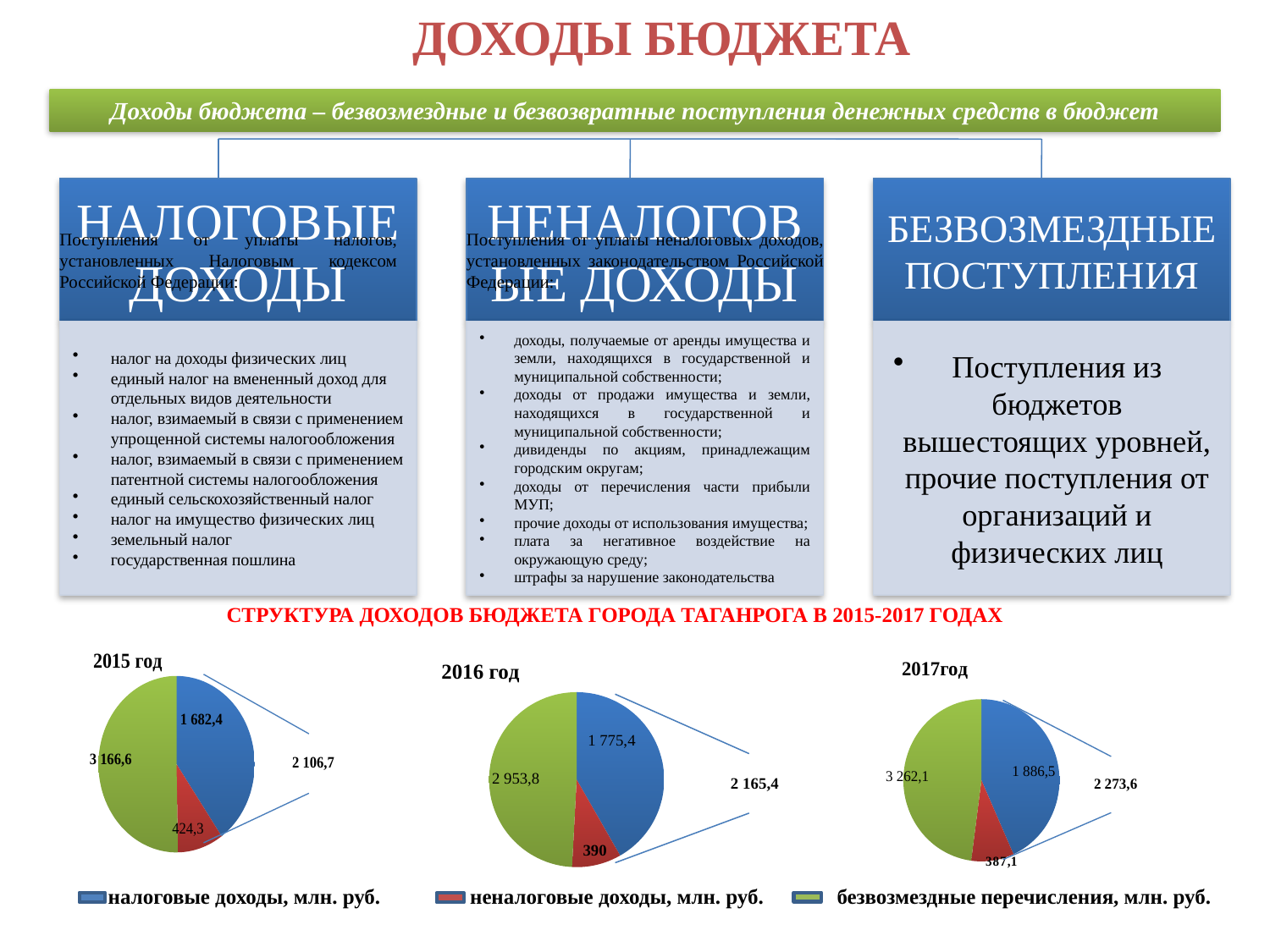
In the 2015 pie chart, what is the value of налоговые доходы (tax revenues)? 1 682,4 How many entries does the legend below the pie charts list? 3 In the 2015 pie chart, what combined value is shown for налоговые and неналоговые доходы together? 2 106,7 In the 2016 pie chart, what is the value of неналоговые доходы (non-tax revenues)? 390 What kind of chart is used to show the structure of Taganrog's budget revenues for 2015, 2016 and 2017? Pie chart Which colour represents неналоговые доходы in the pie charts? Red In the 2017 pie chart, which category has the smallest slice? неналоговые доходы, млн. руб. In the 2016 pie chart, what is the difference between безвозмездные перечисления (2 953,8) and налоговые доходы (1 775,4)? 1 178,4 In the 2015 pie chart, which category has the largest slice? безвозмездные перечисления, млн. руб. In the 2017 pie chart, which is larger: налоговые доходы or неналоговые доходы? налоговые доходы In the 2017 pie chart, what is the value of безвозмездные перечисления (gratuitous transfers)? 3 262,1 How many slices does each of the pie charts for 2015, 2016 and 2017 contain? 3